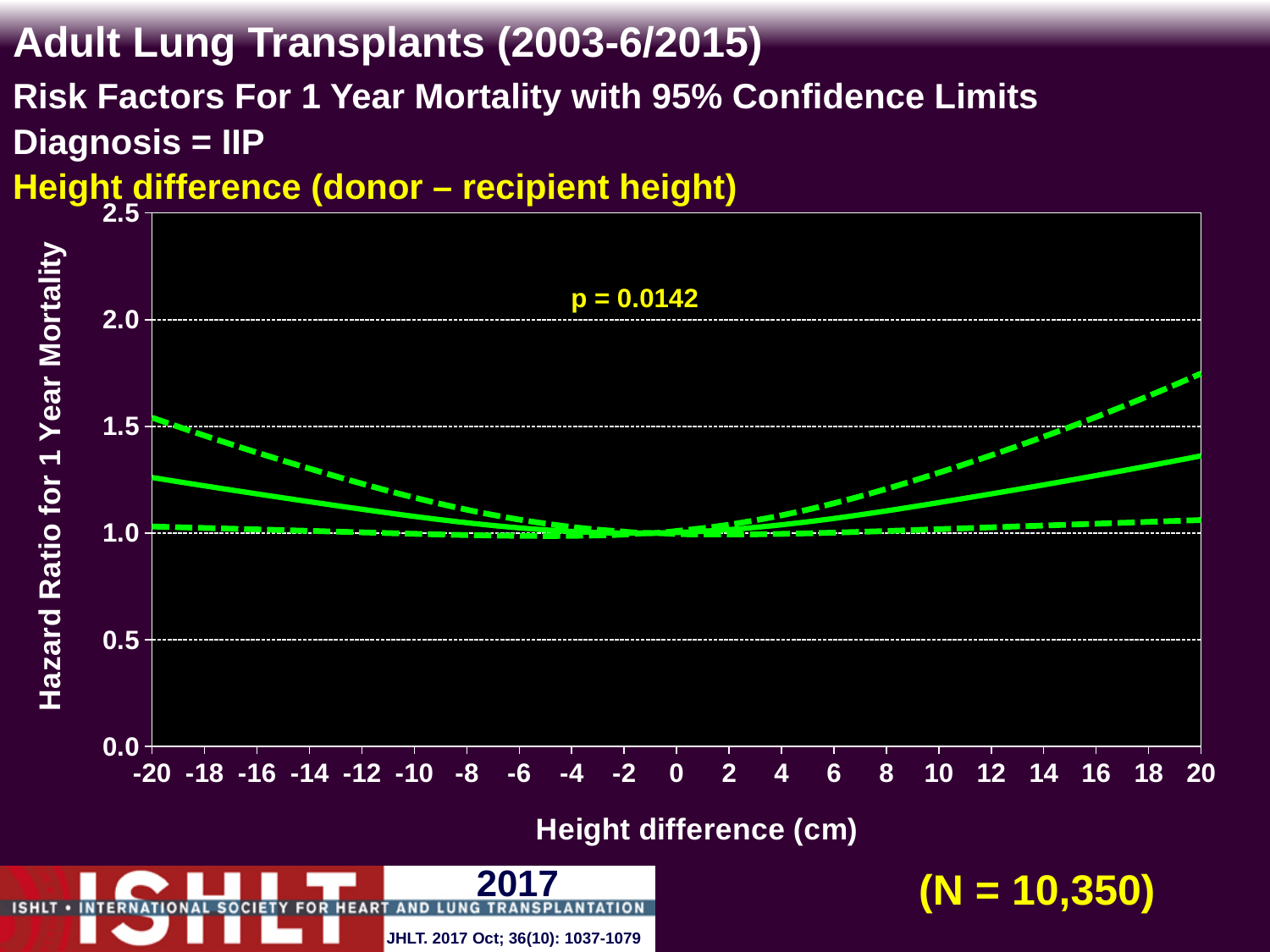
How many lines (the estimate plus its confidence limits) are plotted on the chart? 3 Is the lower 95% confidence limit at a height difference of 20 cm greater or less than 1.5? less How many tick labels are shown along the x axis (Height difference)? 21 Is the upper 95% confidence limit at a height difference of 20 cm greater or less than 1.5? greater Is the upper 95% confidence limit higher at a height difference of 20 cm or at -20 cm? 20 cm What p-value is printed on the chart? p = 0.0142 Is the hazard ratio (solid line) at a height difference of 20 cm greater or less than 1.5? less What kind of chart is shown on the slide? line chart What is the sample size (N) shown on the slide? N = 10,350 Does the hazard ratio (solid line) rise or fall as the height difference goes from 0 cm to 20 cm? rise Does the hazard ratio (solid line) rise or fall as the height difference goes from -20 cm to 0 cm? fall